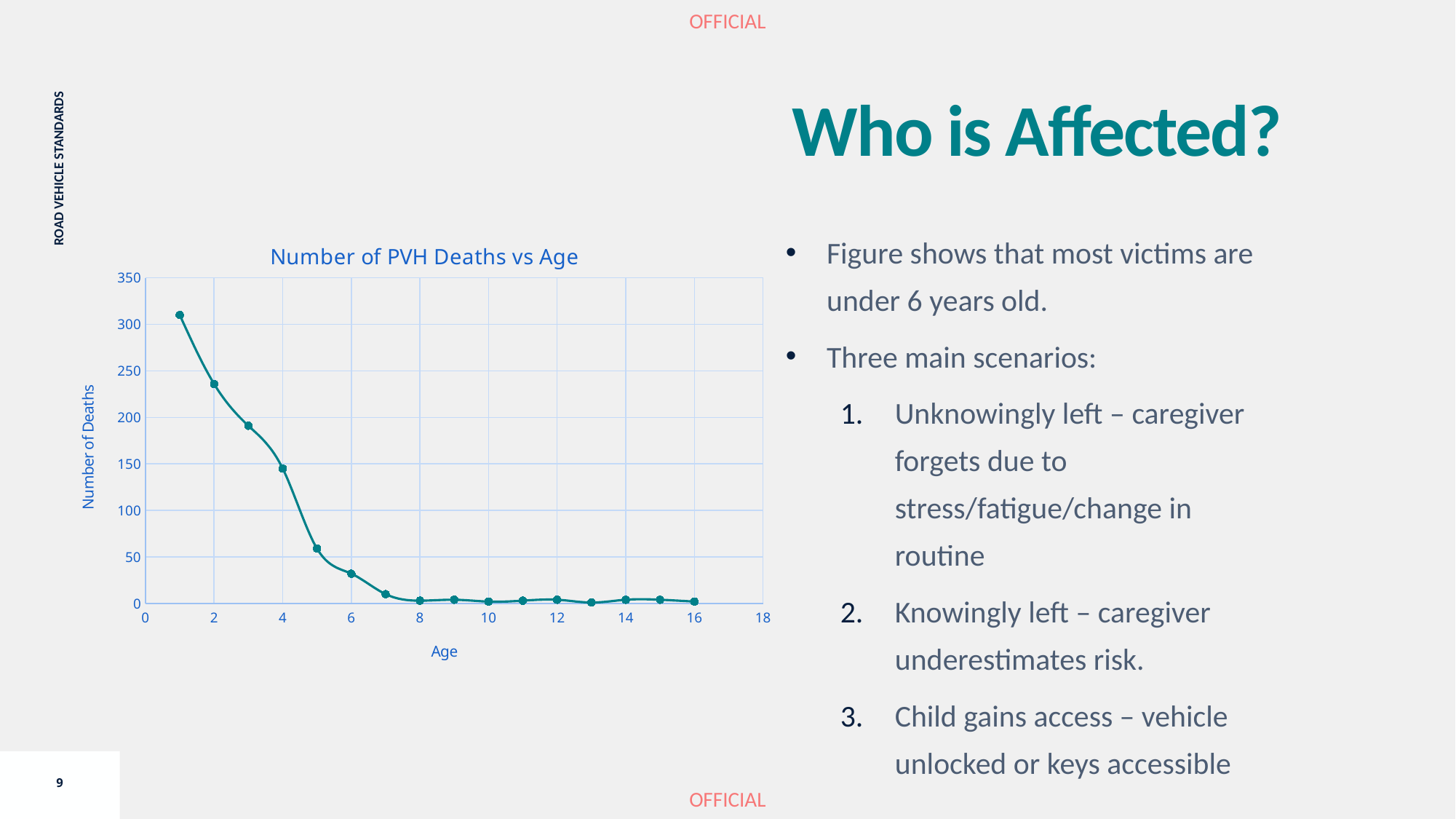
What is the title of the chart? Number of PVH Deaths vs Age Which age has more deaths, age 2 or age 5? Age 2 Which age has more deaths, age 4 or age 7? Age 4 Is the number of deaths at age 6 greater or less than 50? less What is the label of the vertical axis of the chart? Number of Deaths Do the number of deaths rise or fall as age increases along the x axis? Fall Is the number of deaths at age 5 greater or less than 100? less At which age is the number of PVH deaths highest? 1 Is the number of deaths at age 2 greater or less than 200? greater How many data points are plotted on the chart? 16 What kind of chart is shown on the slide? Line chart